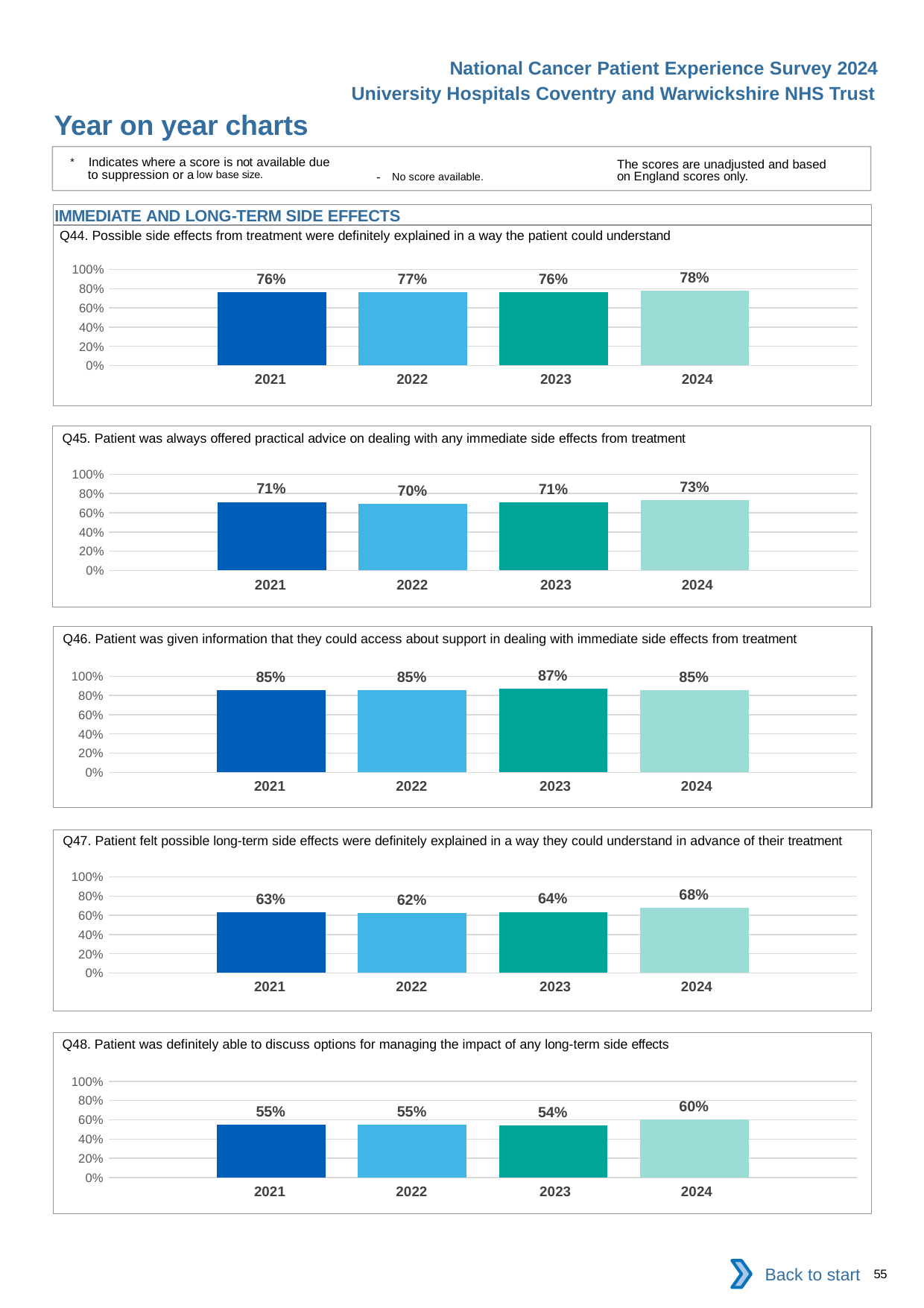
How many charts are shown on the slide? 5 In the Q48 chart, is the value for 2024 larger than the value for 2021? Yes What kind of chart is the Q45 chart? Bar chart In the Q45 chart, which year has the lowest value? 2022 In the Q47 chart, what is the value for 2023? 64% In the Q48 chart, what is the value for 2023? 54% In the Q47 chart, what is the difference between the 2024 and 2022 values? 6% In the Q46 chart, which year has the highest value? 2023 In the Q45 chart, what is the difference between the 2024 and 2021 values? 2% How many years are shown in the Q44 chart? 4 In the Q47 chart, is the value for 2021 greater or less than 80%? less In the Q44 chart, what is the value for 2024? 78%